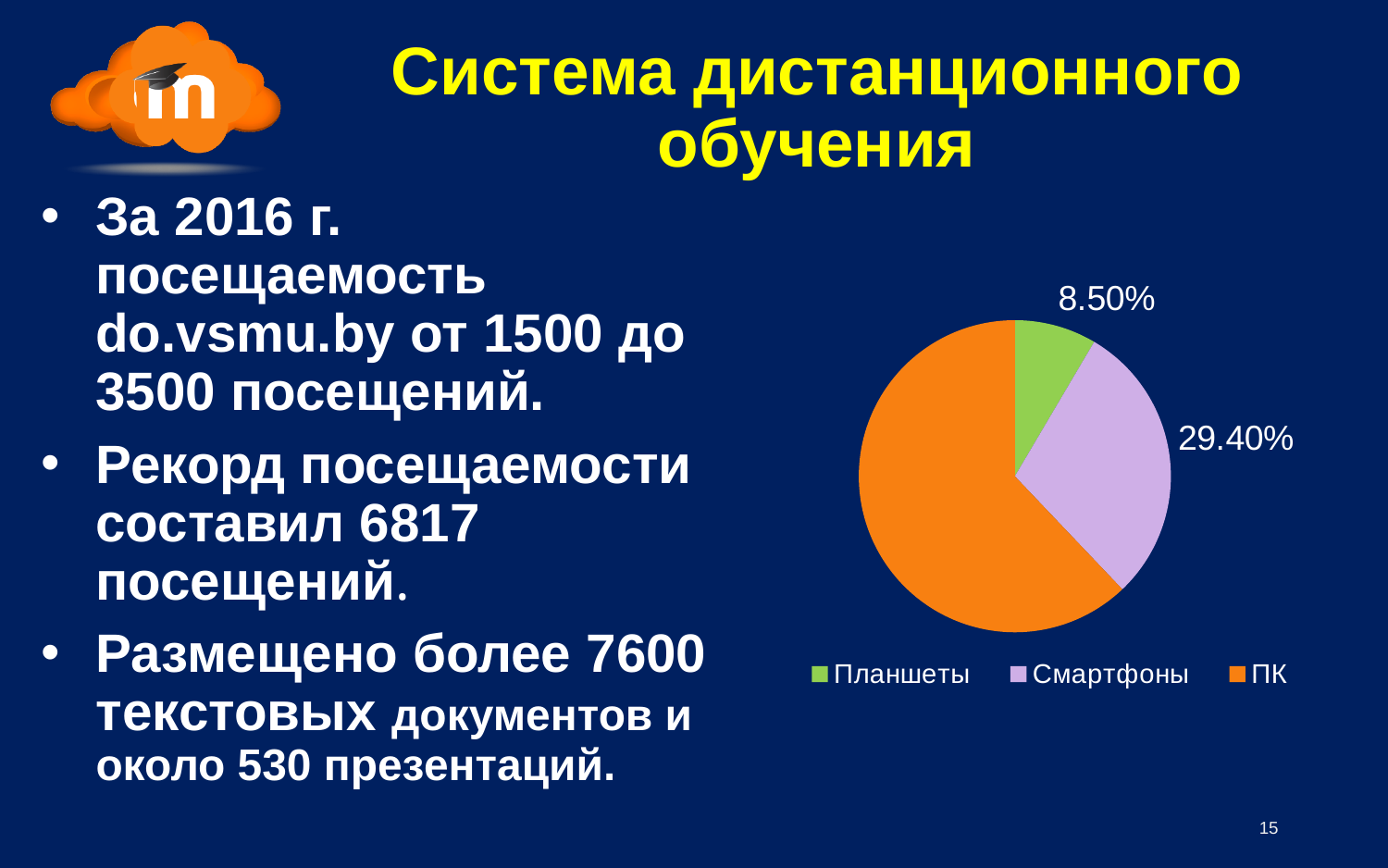
How many slices does the pie chart have? 3 Which category has the largest slice of the pie chart? ПК What colour is the ПК slice in the pie chart? orange How many entries does the legend of the pie chart list? 3 What is the value shown for Смартфоны in the pie chart? 29.40% Which is larger in the pie chart, ПК or Смартфоны? ПК What is the value shown for Планшеты in the pie chart? 8.50% What is the difference between the values for Смартфоны and Планшеты? 20.90% Which is larger in the pie chart, Смартфоны or Планшеты? Смартфоны What kind of chart is shown on the slide? pie chart What colour is the Планшеты slice in the pie chart? green Which category has the smallest slice of the pie chart? Планшеты